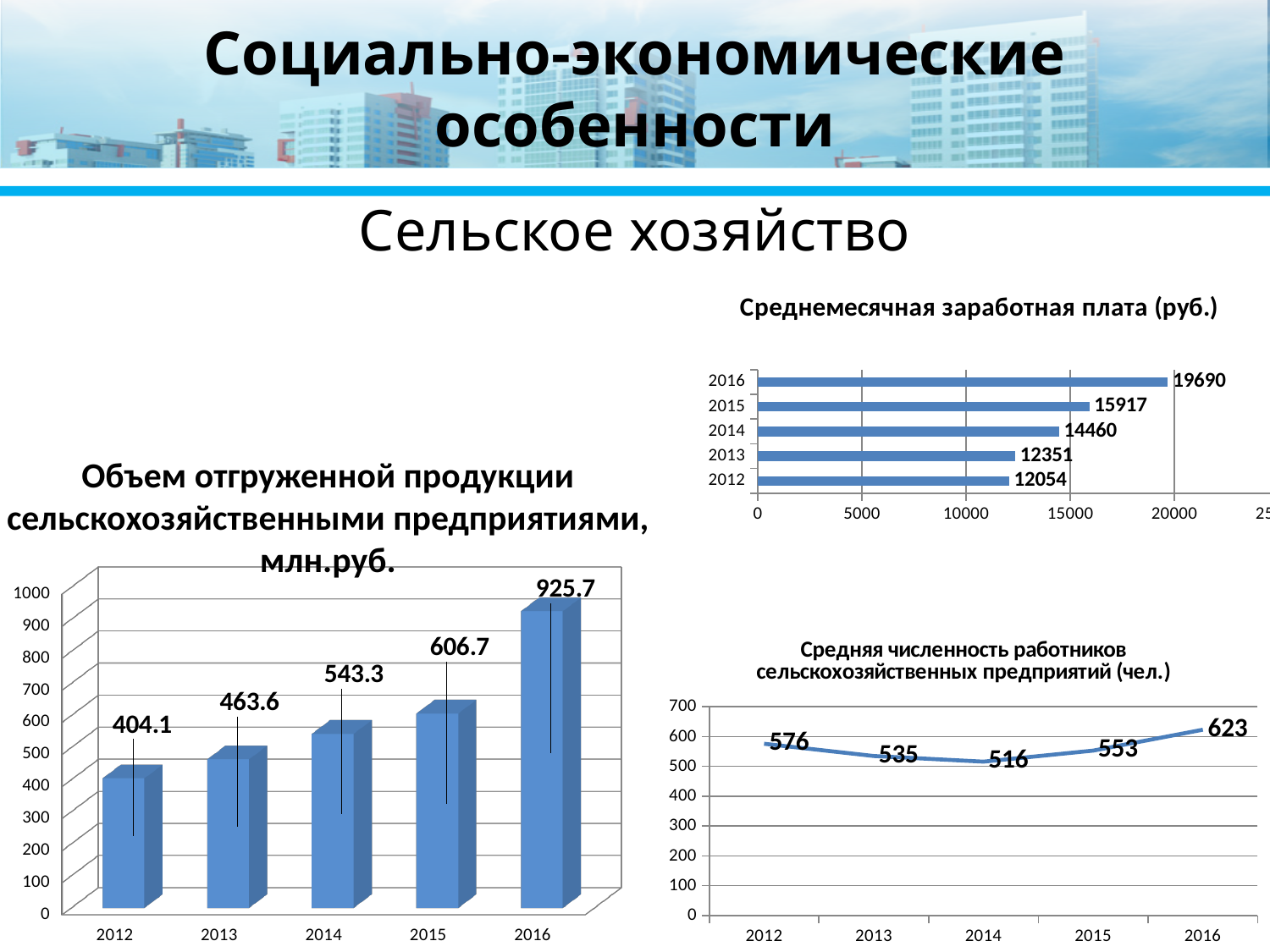
What kind of chart is 'Объем отгруженной продукции сельскохозяйственными предприятиями, млн.руб.'? bar chart In the chart 'Среднемесячная заработная плата (руб.)', what is the difference between the 2013 and 2012 values? 297 In the chart 'Средняя численность работников сельскохозяйственных предприятий (чел.)', what is the value for 2014? 516 In the chart 'Объем отгруженной продукции сельскохозяйственными предприятиями, млн.руб.', what is the value for 2016? 925.7 In the chart 'Средняя численность работников сельскохозяйственных предприятий (чел.)', which is larger, the value for 2012 or the value for 2015? 2012 In the chart 'Объем отгруженной продукции сельскохозяйственными предприятиями, млн.руб.', which year has the lowest value? 2012 In the chart 'Среднемесячная заработная плата (руб.)', which year has the highest value? 2016 In the chart 'Объем отгруженной продукции сельскохозяйственными предприятиями, млн.руб.', do the values rise or fall from 2012 to 2016? rise What kind of chart is 'Средняя численность работников сельскохозяйственных предприятий (чел.)'? line chart In the chart 'Объем отгруженной продукции сельскохозяйственными предприятиями, млн.руб.', what is the difference between the 2016 and 2015 values? 319 In the chart 'Среднемесячная заработная плата (руб.)', how many years are shown? 5 In the chart 'Среднемесячная заработная плата (руб.)', what is the value for 2014? 14460